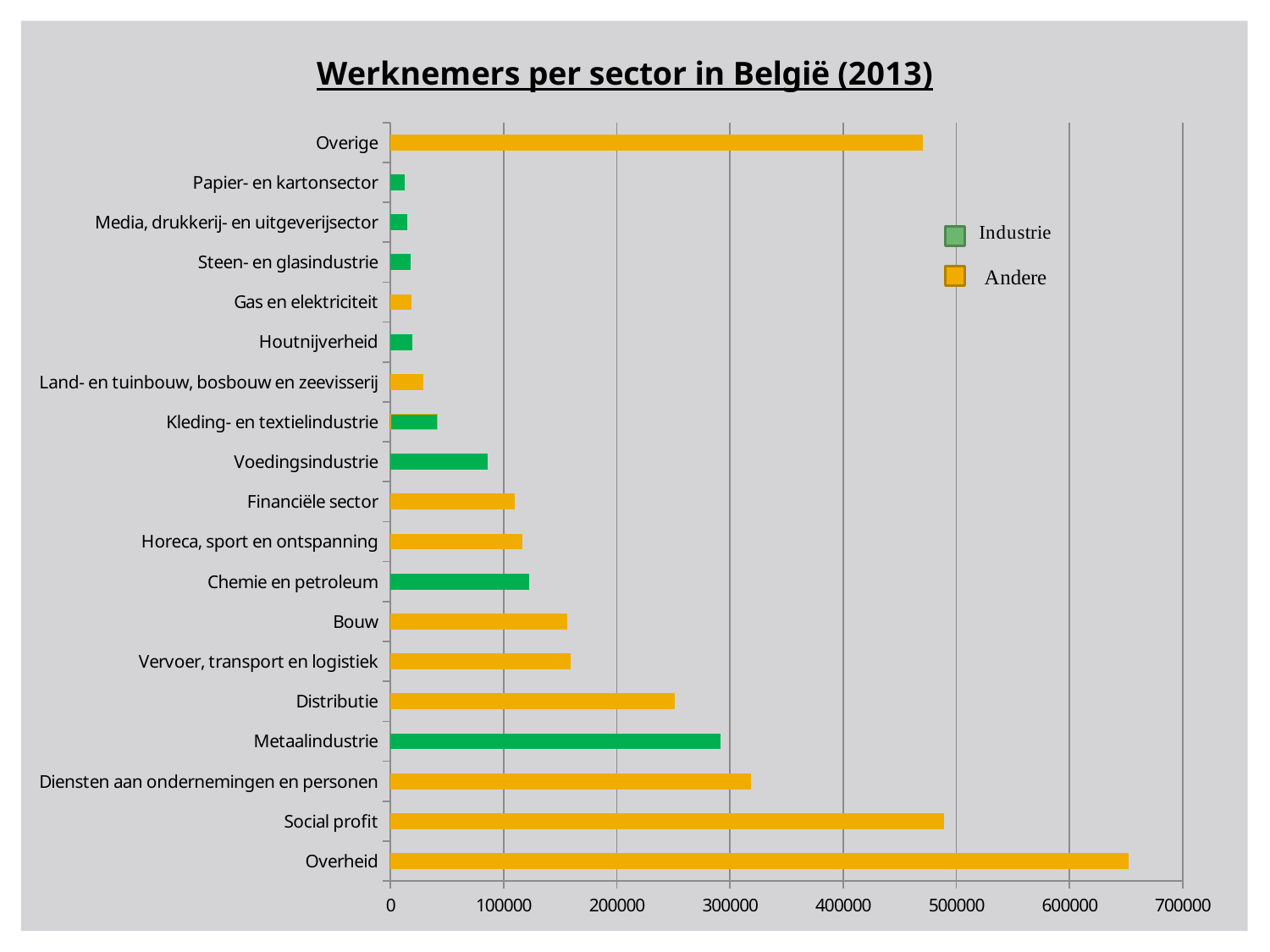
Which is larger, the value for Metaalindustrie or the value for Distributie? Metaalindustrie Which is larger, the value for Overheid or the value for Social profit? Overheid Is the value for Overige greater or less than 500000? less How many series does the legend list? 2 Is the value for Voedingsindustrie greater or less than 100000? less Which sector has the highest number of employees? Overheid What kind of chart is shown on the slide? bar chart How many sectors (categories) are plotted in the chart? 19 Is the value for Distributie greater or less than 200000? greater Which colour represents the Industrie series in the legend? green What is the title of the chart? Werknemers per sector in België (2013)